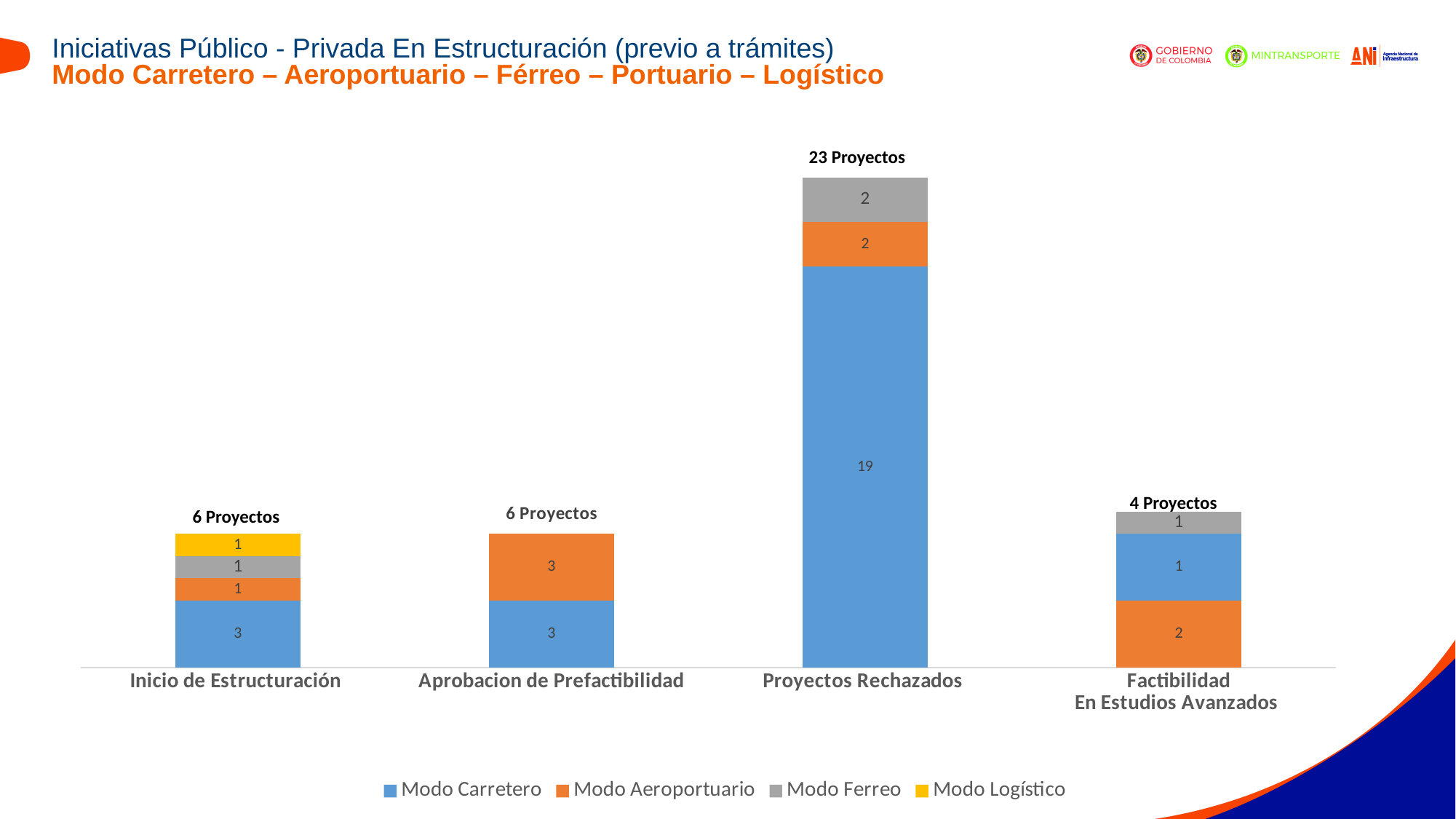
What is the value for Modo Carretero in the Proyectos Rechazados bar? 19 What is the difference between the total for Proyectos Rechazados and the total for Inicio de Estructuración? 17 What is the value for Modo Logístico in the Inicio de Estructuración bar? 1 Which series is shown in yellow in the legend? Modo Logístico What is the total labelled above the Proyectos Rechazados bar? 23 Proyectos What is the total labelled above the Factibilidad En Estudios Avanzados bar? 4 Proyectos How many categories are shown on the x axis of the chart? 4 Which category has the lowest total number of projects? Factibilidad En Estudios Avanzados Which category has the highest total number of projects? Proyectos Rechazados What is the value for Modo Aeroportuario in the Aprobacion de Prefactibilidad bar? 3 What kind of chart is shown on the slide? Stacked bar chart How many series does the legend list? 4